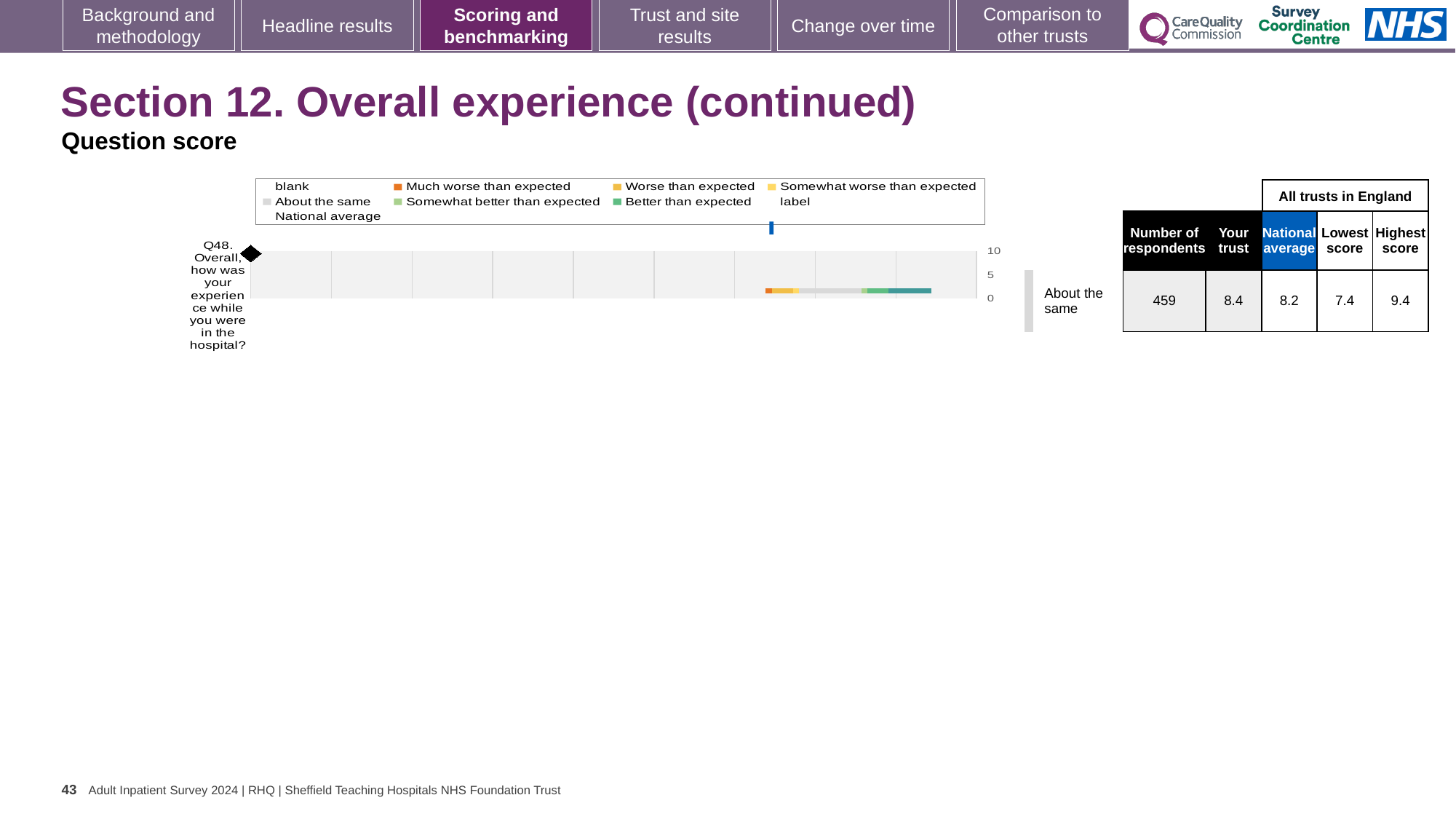
What is the number of respondents for Q48? 459 What is the lowest score among all trusts in England for Q48? 7.4 Which question is plotted in the chart? Q48. Overall, how was your experience while you were in the hospital? Which is larger for Q48, the 'Your trust' score or the national average? Your trust What kind of chart is shown for Q48 on the slide? bar chart What is the highest tick value shown on the chart's axis? 10 What is the highest score among all trusts in England for Q48? 9.4 How many questions are plotted in the chart? 1 What benchmark category is given for Q48? About the same What is the national average score for Q48? 8.2 What is the 'Your trust' score for Q48? 8.4 What is the difference between the 'Your trust' score and the national average for Q48? 0.2